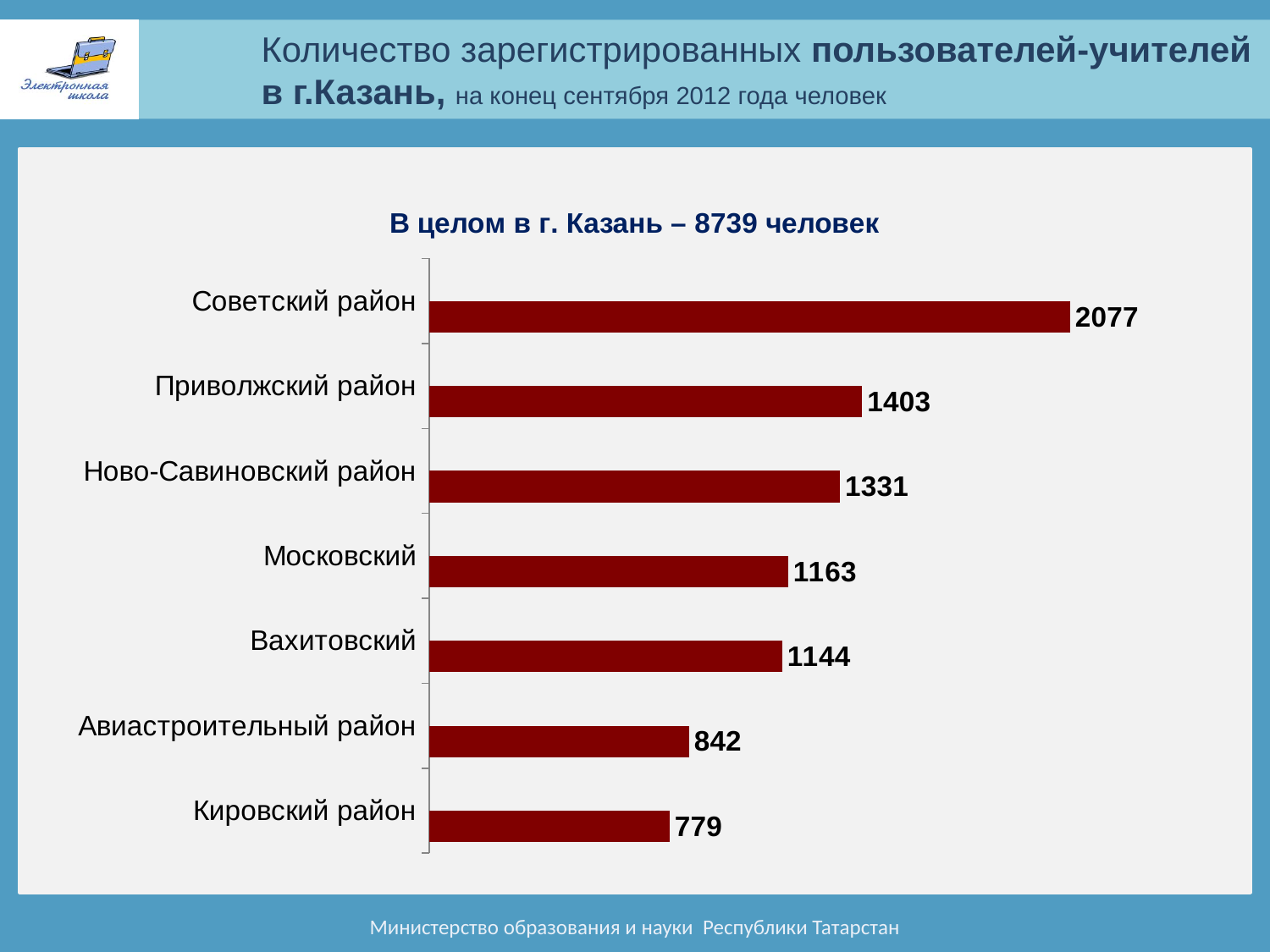
What is the value shown for Кировский район? 779 Which has a larger value, Московский or Вахитовский? Московский What type of chart is shown on the slide? bar chart Which has a larger value, Приволжский район or Ново-Савиновский район? Приволжский район Which district has the lowest number of registered teacher-users? Кировский район What is the value shown for Московский? 1163 How many districts are shown in the chart? 7 According to the text above the chart, what is the total number of registered teacher-users in Kazan? 8739 человек Which district has the highest number of registered teacher-users? Советский район What is the number of registered teacher-users for Советский район? 2077 What is the difference between the values for Советский район and Приволжский район? 674 What is the difference between the values for Авиастроительный район and Кировский район? 63